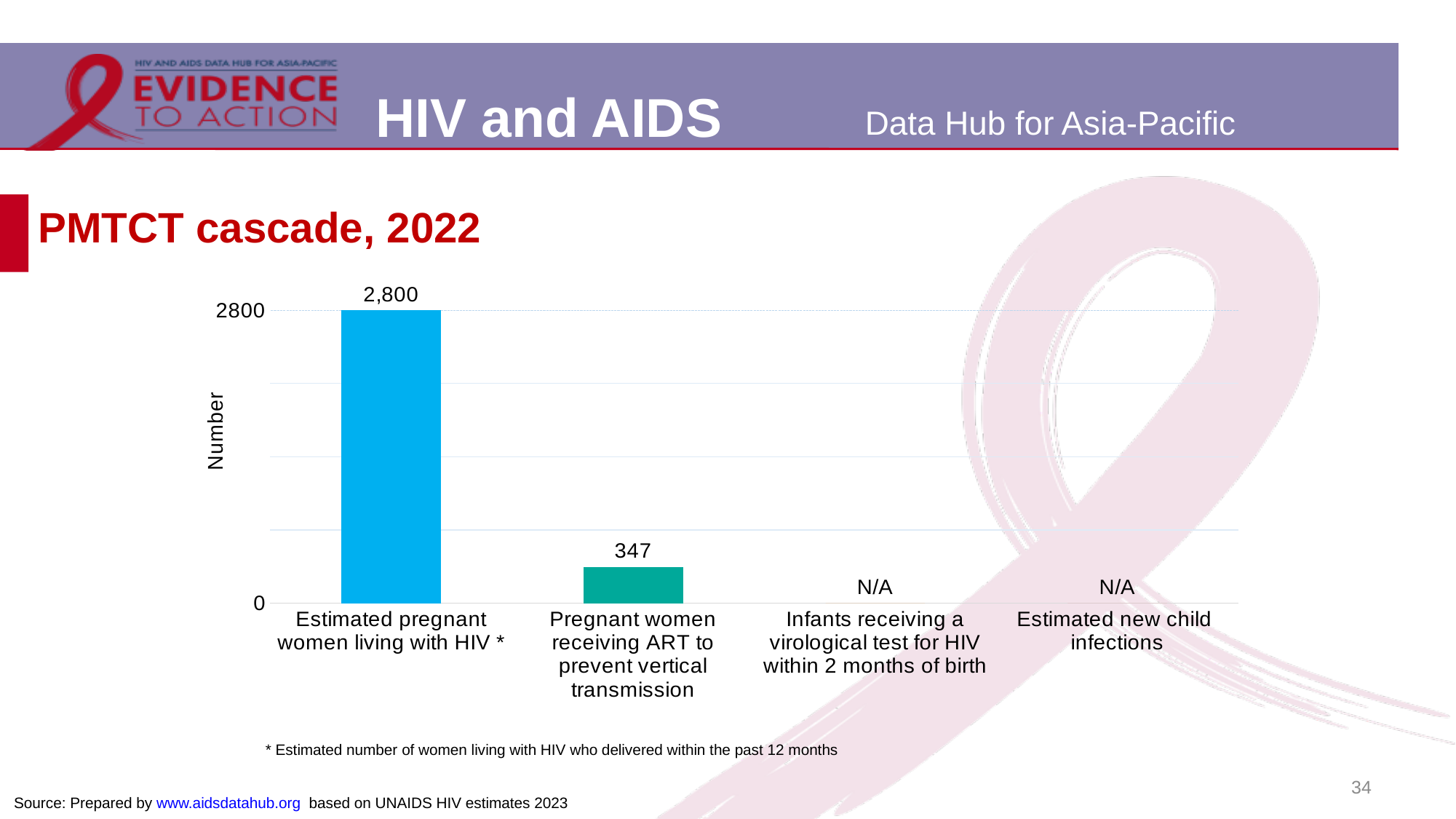
What is shown for Estimated new child infections? N/A Which category has the highest value? Estimated pregnant women living with HIV What is the value for Estimated pregnant women living with HIV? 2,800 What is the title of the chart? PMTCT cascade, 2022 How many categories are shown on the x axis? 4 What is shown for Infants receiving a virological test for HIV within 2 months of birth? N/A Which is larger: Estimated pregnant women living with HIV or Pregnant women receiving ART to prevent vertical transmission? Estimated pregnant women living with HIV How many categories have a value of N/A? 2 What is the value for Pregnant women receiving ART to prevent vertical transmission? 347 What is the difference between Estimated pregnant women living with HIV and Pregnant women receiving ART to prevent vertical transmission? 2,453 What kind of chart is this? Bar chart What is the label of the y axis? Number